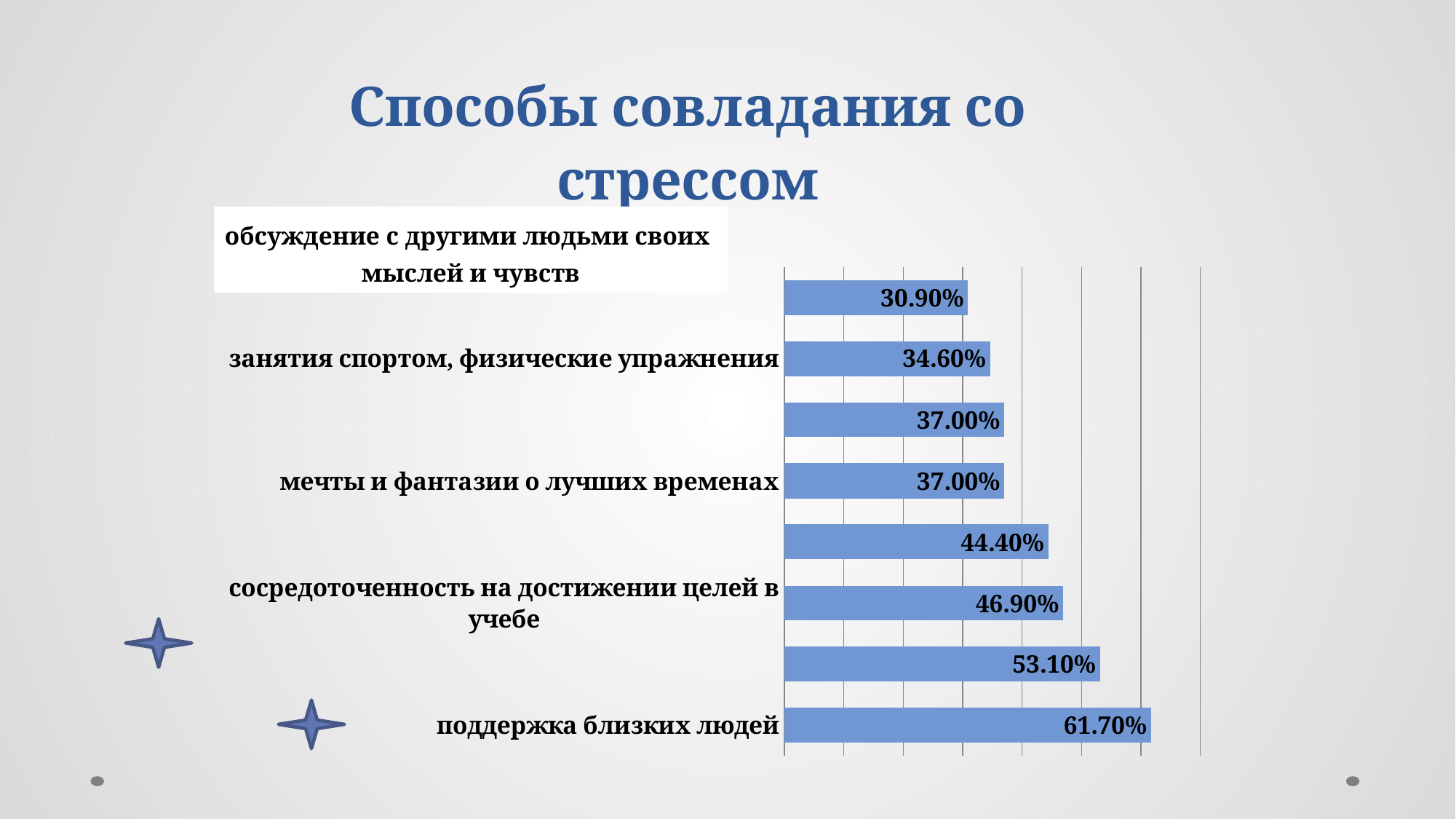
Which category has the lowest value? обсуждение с другими людьми своих мыслей и чувств What is the value for "сосредоточенность на достижении целей в учебе"? 46.90% What is the value for "обсуждение с другими людьми своих мыслей и чувств"? 30.90% What type of chart is shown on the slide? bar chart How many bars are plotted in the chart? 8 Which category has the highest value? поддержка близких людей What is the value for "поддержка близких людей"? 61.70% Which is larger: the value for "занятия спортом, физические упражнения" or the value for "мечты и фантазии о лучших временах"? мечты и фантазии о лучших временах What is the title of the chart on the slide? Способы совладания со стрессом What is the difference between the values for "поддержка близких людей" and "сосредоточенность на достижении целей в учебе"? 14.80% What is the value for "мечты и фантазии о лучших временах"? 37.00% What is the value for "занятия спортом, физические упражнения"? 34.60%